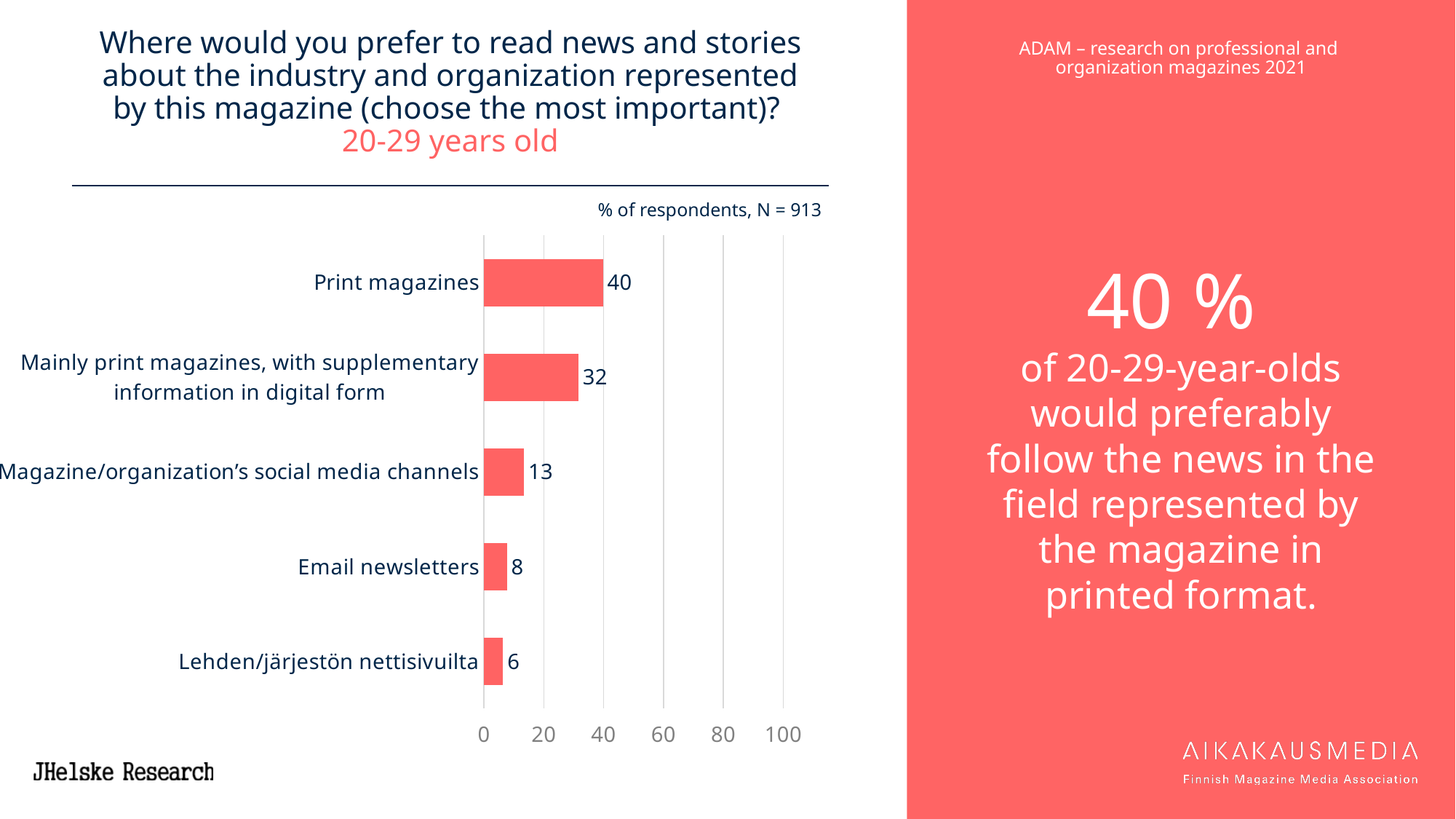
What kind of chart is shown on the slide? Bar chart Which age group does the chart cover, according to the subtitle? 20-29 years old How many categories are shown in the chart? 5 What is the difference between the values for Print magazines and Mainly print magazines, with supplementary information in digital form? 8 Which category has the highest value? Print magazines What percentage of respondents chose Print magazines? 40 What is the sample size (N) stated above the chart? 913 What is the value for Email newsletters? 8 Which category has the lowest value? Lehden/järjestön nettisivuilta What is the value for Magazine/organization's social media channels? 13 Which is larger: the value for Email newsletters or the value for Magazine/organization's social media channels? Magazine/organization's social media channels What is the value for Lehden/järjestön nettisivuilta? 6